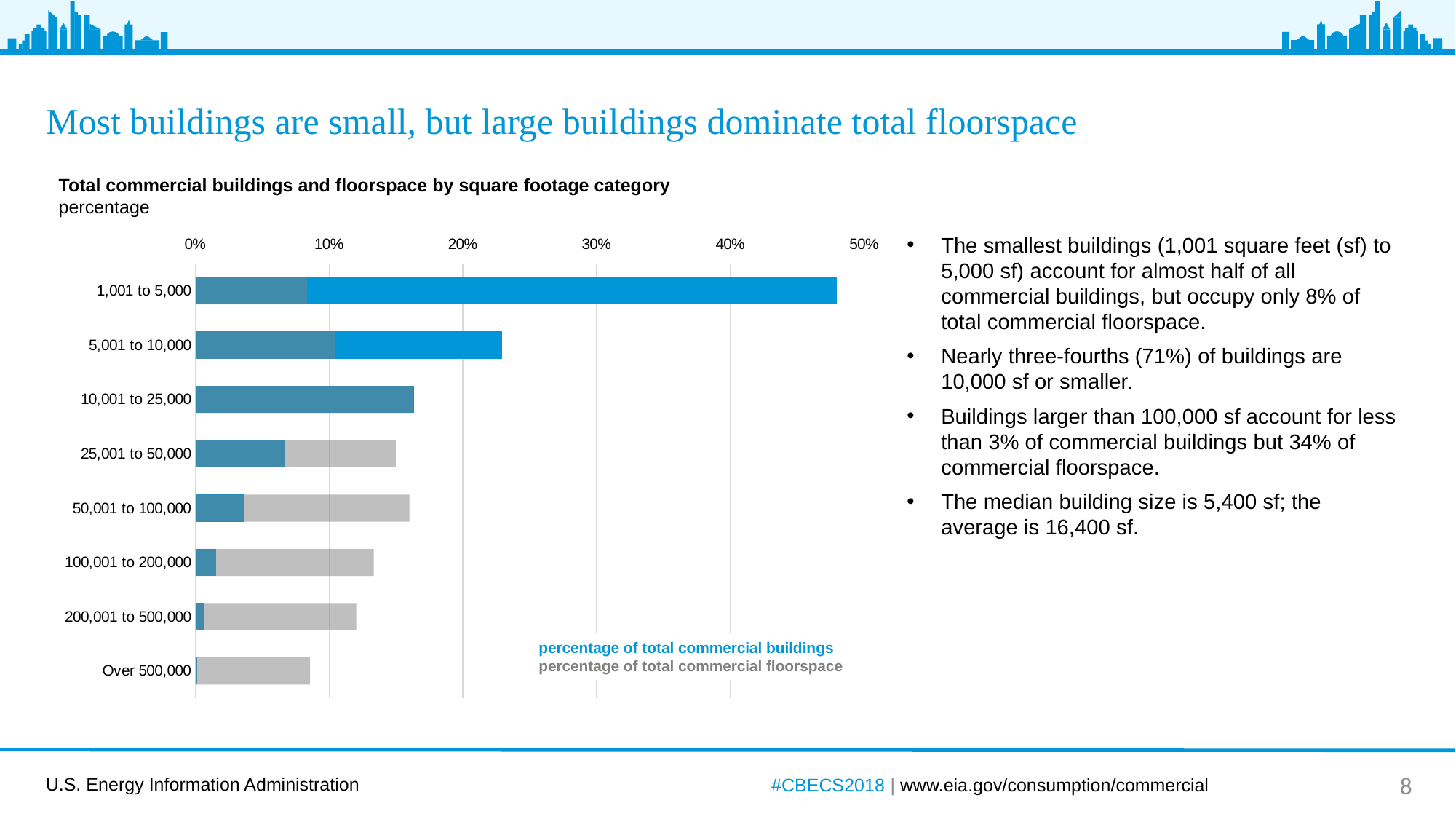
What kind of chart is shown on the slide? bar chart Is the percentage of total commercial buildings for the 1,001 to 5,000 category greater or less than 40%? greater Which has a larger percentage of total commercial floorspace: the 25,001 to 50,000 category or the Over 500,000 category? 25,001 to 50,000 How many square footage categories are plotted on the chart? 8 What is the title of the chart? Total commercial buildings and floorspace by square footage category Which square footage category has the highest percentage of total commercial buildings? 1,001 to 5,000 Which square footage category has the lowest percentage of total commercial buildings? Over 500,000 Is the percentage of total commercial floorspace for the 1,001 to 5,000 category greater or less than 10%? less Does the percentage of total commercial buildings rise or fall as the square footage category increases? fall Is the percentage of total commercial buildings for the 5,001 to 10,000 category greater or less than 20%? greater How many series does the chart's legend list? 2